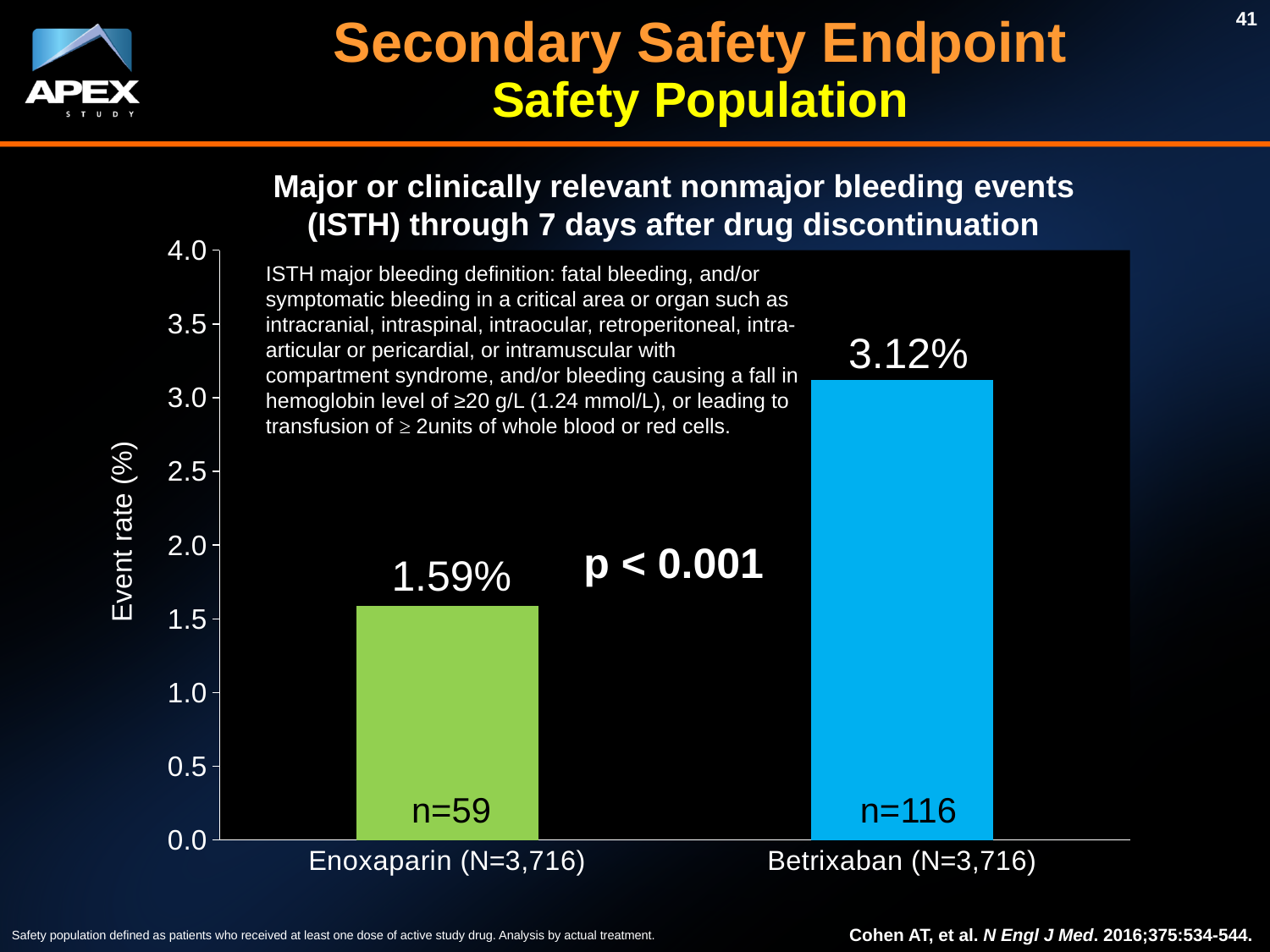
Is the event rate for Betrixaban greater or less than 3.0? greater Which group has the lower event rate? Enoxaparin (N=3,716) What is the difference in event rate between Betrixaban and Enoxaparin? 1.53% How many events (n) are shown for the Betrixaban bar? n=116 How many groups are plotted in the chart? 2 What is the label of the y axis? Event rate (%) How many events (n) are shown for the Enoxaparin bar? n=59 What is the event rate for Betrixaban (N=3,716)? 3.12% What kind of chart is shown on the slide? Bar chart Which group has the higher event rate? Betrixaban (N=3,716) Is the event rate for Enoxaparin greater or less than 2.0? less What is the event rate for Enoxaparin (N=3,716)? 1.59%